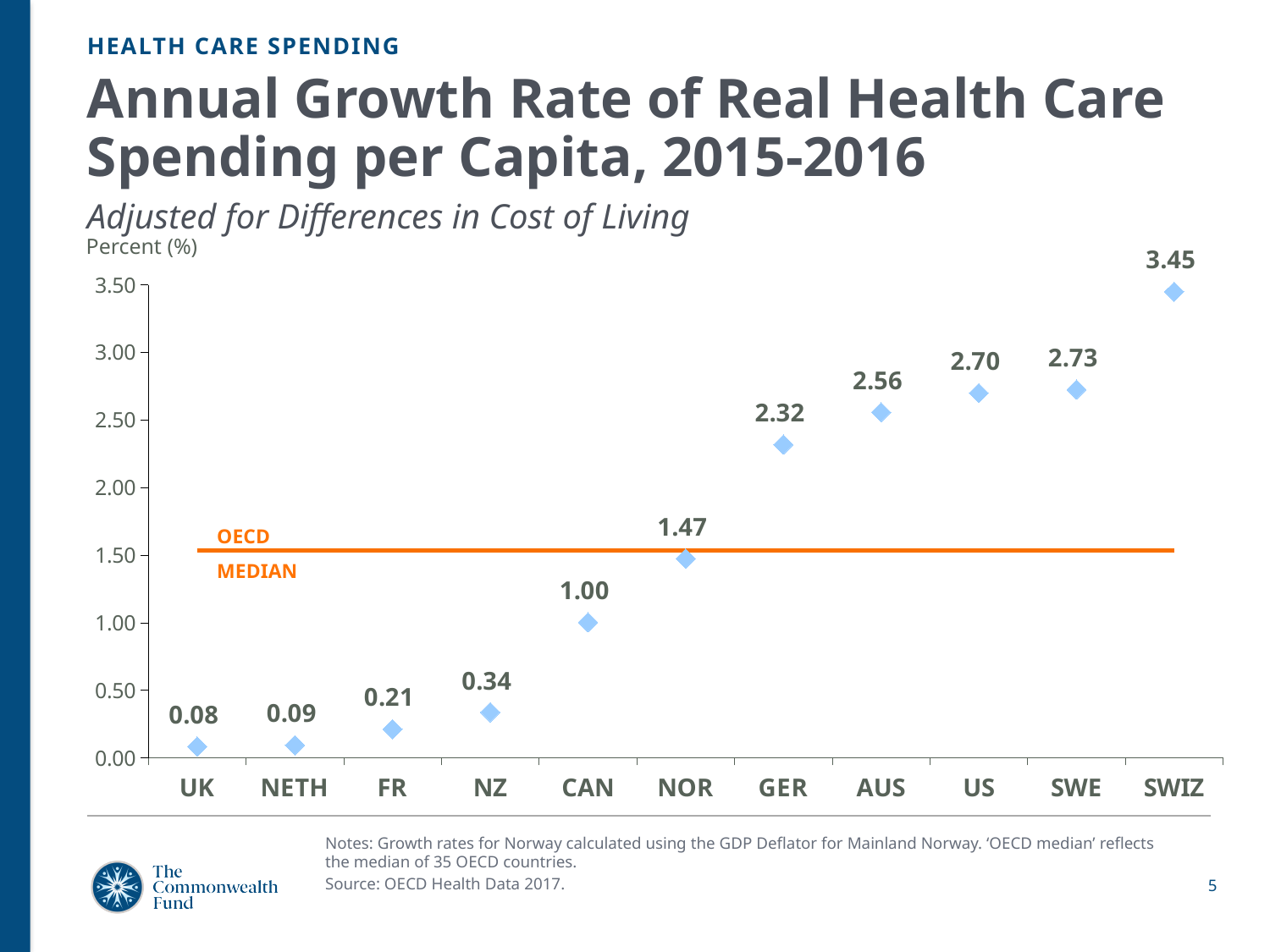
What is the difference between the values for Switzerland (SWIZ) and the UK? 3.37 What is the value shown for Germany (GER)? 2.32 Which country has the lowest annual growth rate on the chart? UK What kind of chart is shown on the slide? Scatter chart What is the annual growth rate of real health care spending per capita for Switzerland (SWIZ)? 3.45 What is the value shown for Canada (CAN)? 1.00 Is the value for New Zealand (NZ) greater or less than 0.50? less What does the orange horizontal line on the chart represent? OECD median How many countries are plotted on the chart? 11 What is the difference between the values for Sweden (SWE) and the US? 0.03 Which has a higher value, Australia (AUS) or Norway (NOR)? AUS Which country has the highest annual growth rate on the chart? SWIZ